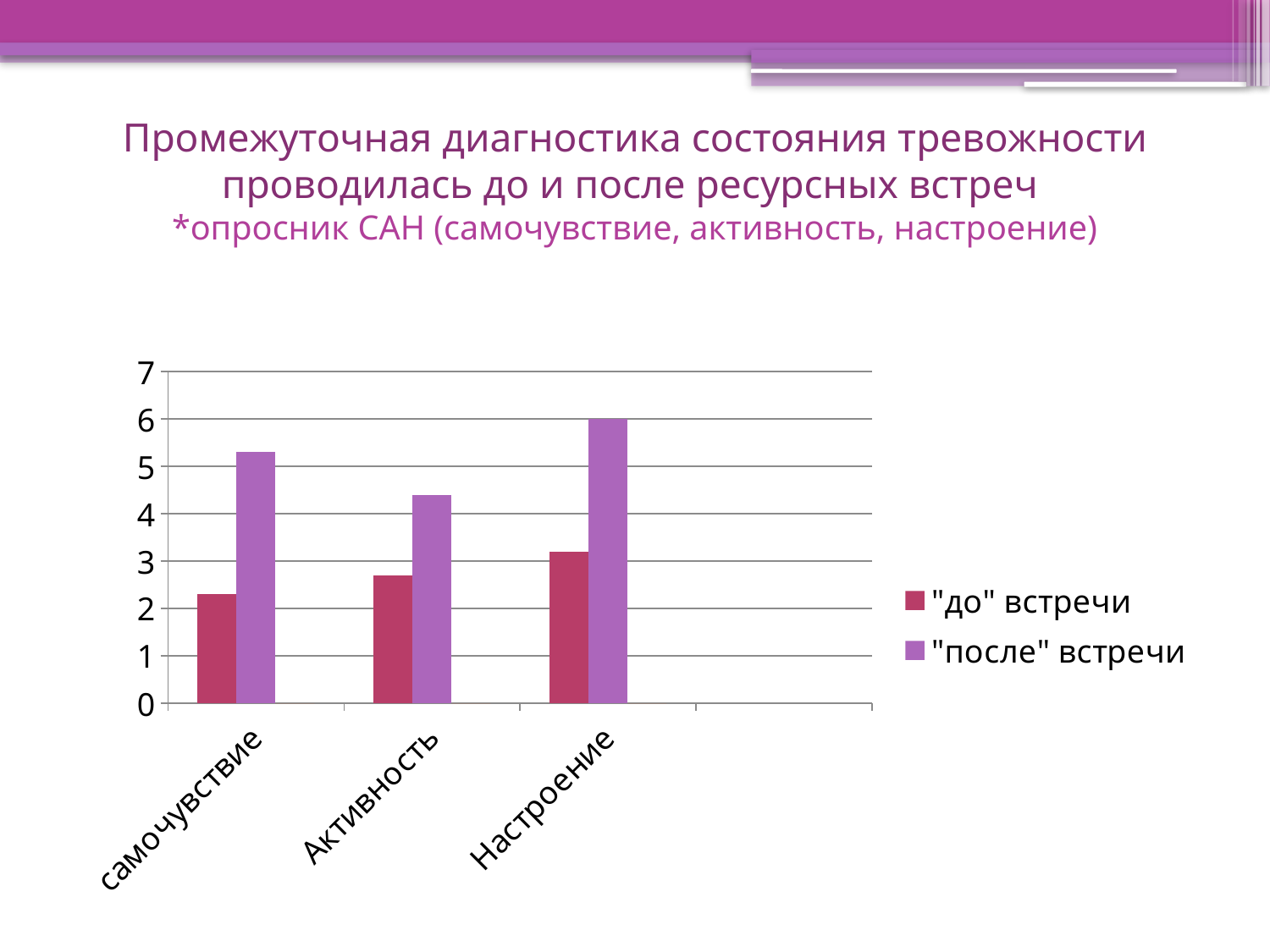
Is the value for Активность in the "после" встречи series greater or less than 4? greater What is the value for Настроение in the "после" встречи series? 6 How many series does the chart's legend list? 2 Which is larger: the "после" встречи value for Настроение or the "после" встречи value for Активность? Настроение Do the "до" встречи values rise or fall from самочувствие to Настроение along the x axis? rise Is the value for Настроение in the "до" встречи series greater or less than 4? less Which category has the lowest value for the "до" встречи series? самочувствие Which category has the highest value for the "после" встречи series? Настроение What are the two series named in the legend? "до" встречи and "после" встречи How many categories are shown on the x axis of the chart? 3 Is the value for самочувствие in the "до" встречи series greater or less than 3? less What kind of chart is shown on the slide? bar chart